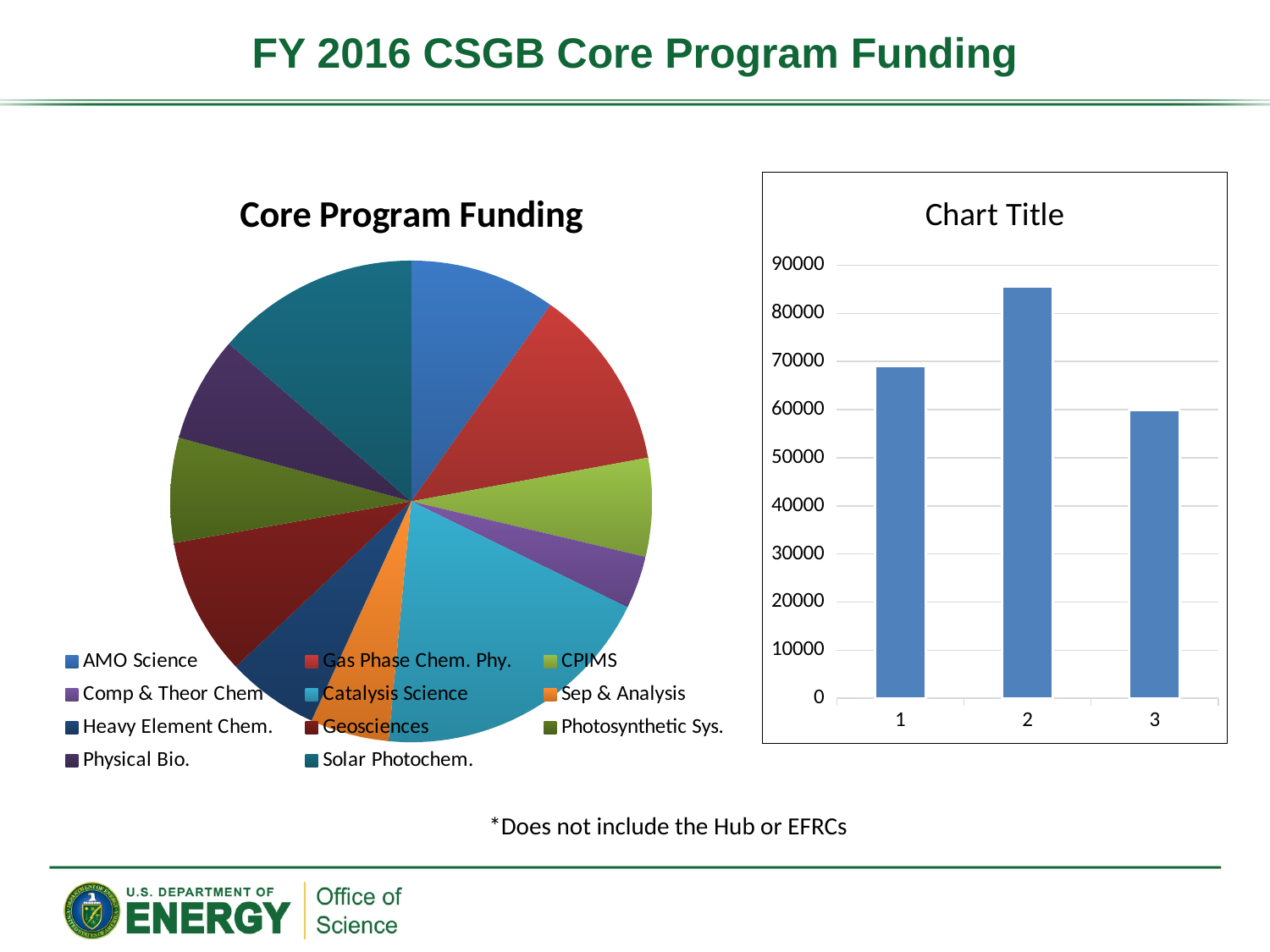
In the "Chart Title" bar chart, is the value for category 2 greater or less than 80000? greater In the "Chart Title" bar chart, which is larger, the value for category 1 or the value for category 3? category 1 In the "Chart Title" bar chart, which category has the highest bar? 2 What is the title of the pie chart on the left of the slide? Core Program Funding In the "Core Program Funding" pie chart, which category has the largest slice? Catalysis Science In the "Chart Title" bar chart, how many bars are plotted? 3 How many categories does the legend of the "Core Program Funding" pie chart list? 11 What kind of chart is the chart titled "Chart Title" on the right of the slide? bar chart In the "Chart Title" bar chart, is the value for category 3 greater or less than 50000? greater What kind of chart is the "Core Program Funding" chart on the left of the slide? pie chart In the "Chart Title" bar chart, which category has the lowest bar? 3